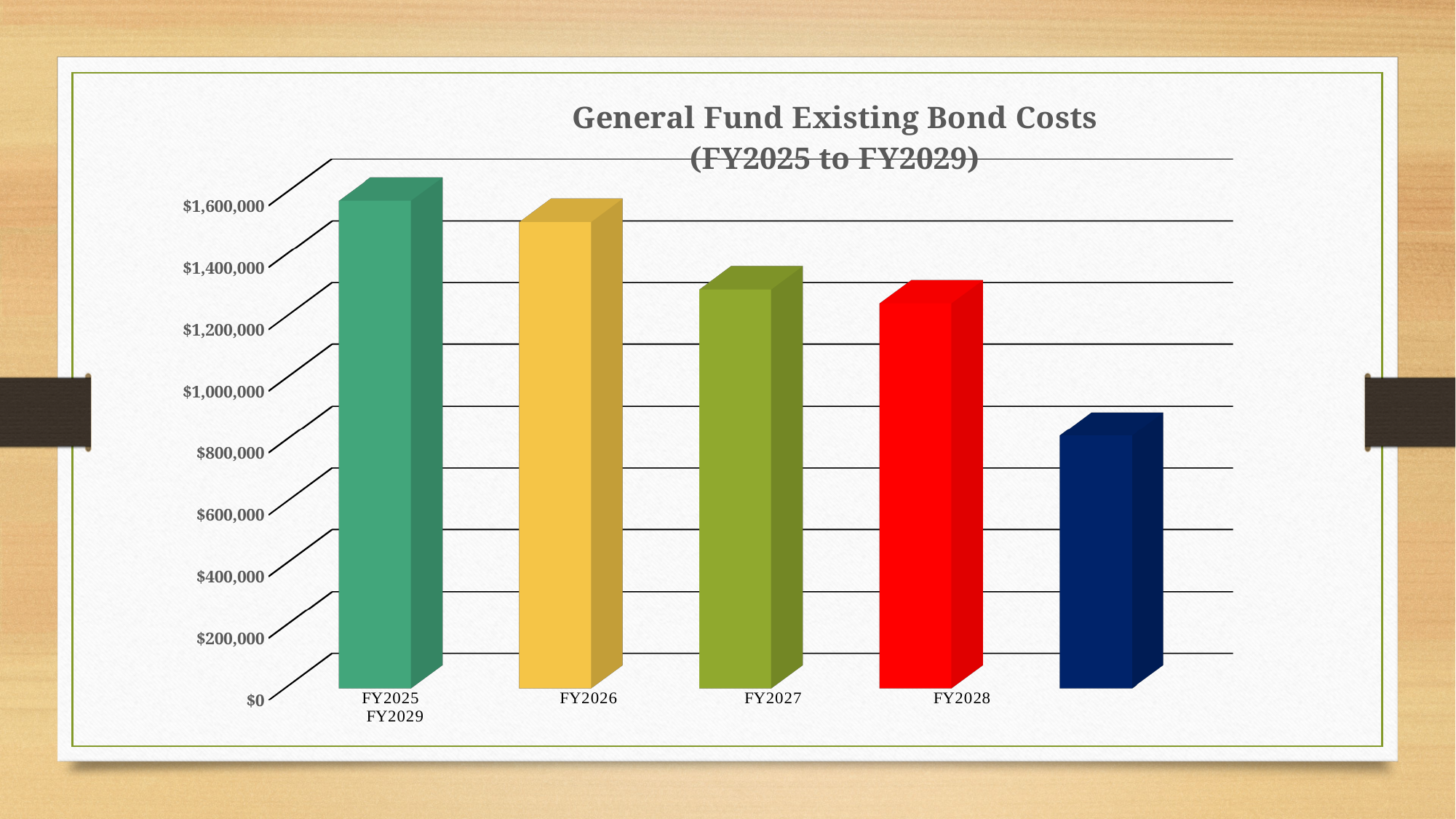
How many bars are plotted in the chart? 5 What is the title of the chart? General Fund Existing Bond Costs (FY2025 to FY2029) Is the value for FY2025 greater or less than $1,400,000? greater Which fiscal year has the highest General Fund Existing Bond Cost? FY2025 Is the value for FY2027 greater or less than $1,200,000? greater Is the value of the rightmost (dark blue) bar greater or less than $1,000,000? less Do the bond costs rise or fall from left to right across the fiscal years? fall Which is larger, the value for FY2026 or the value for FY2027? FY2026 Which bar is the lowest in the chart? the rightmost (dark blue) bar What kind of chart is shown on the slide? bar chart What colour is the bar for FY2028? red